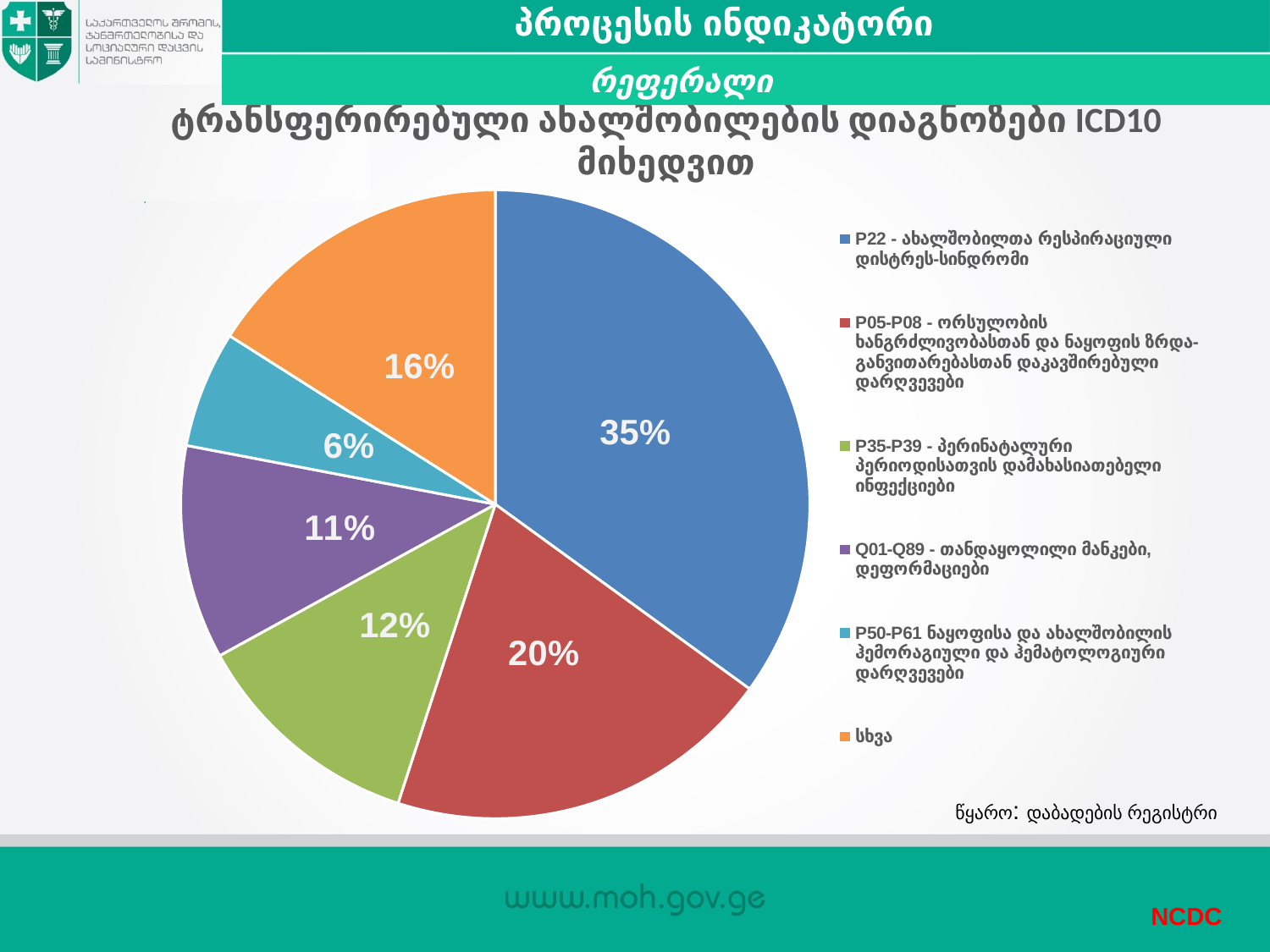
What share of the pie does the P22 slice represent? 35% What share of the pie does the P35-P39 slice represent? 12% What share of the pie does the P05-P08 slice represent? 20% What share of the pie does the Q01-Q89 slice represent? 11% What is the difference in percentage points between the P22 slice and the P05-P08 slice? 15 Which is larger, the share for P35-P39 or the share for Q01-Q89? P35-P39 What share of the pie does the სხვა (other) slice represent? 16% How many slices does the pie chart have? 6 Which category has the largest share of the pie? P22 What share of the pie does the P50-P61 slice represent? 6% What kind of chart is shown on the slide? pie chart Which category has the smallest share of the pie? P50-P61